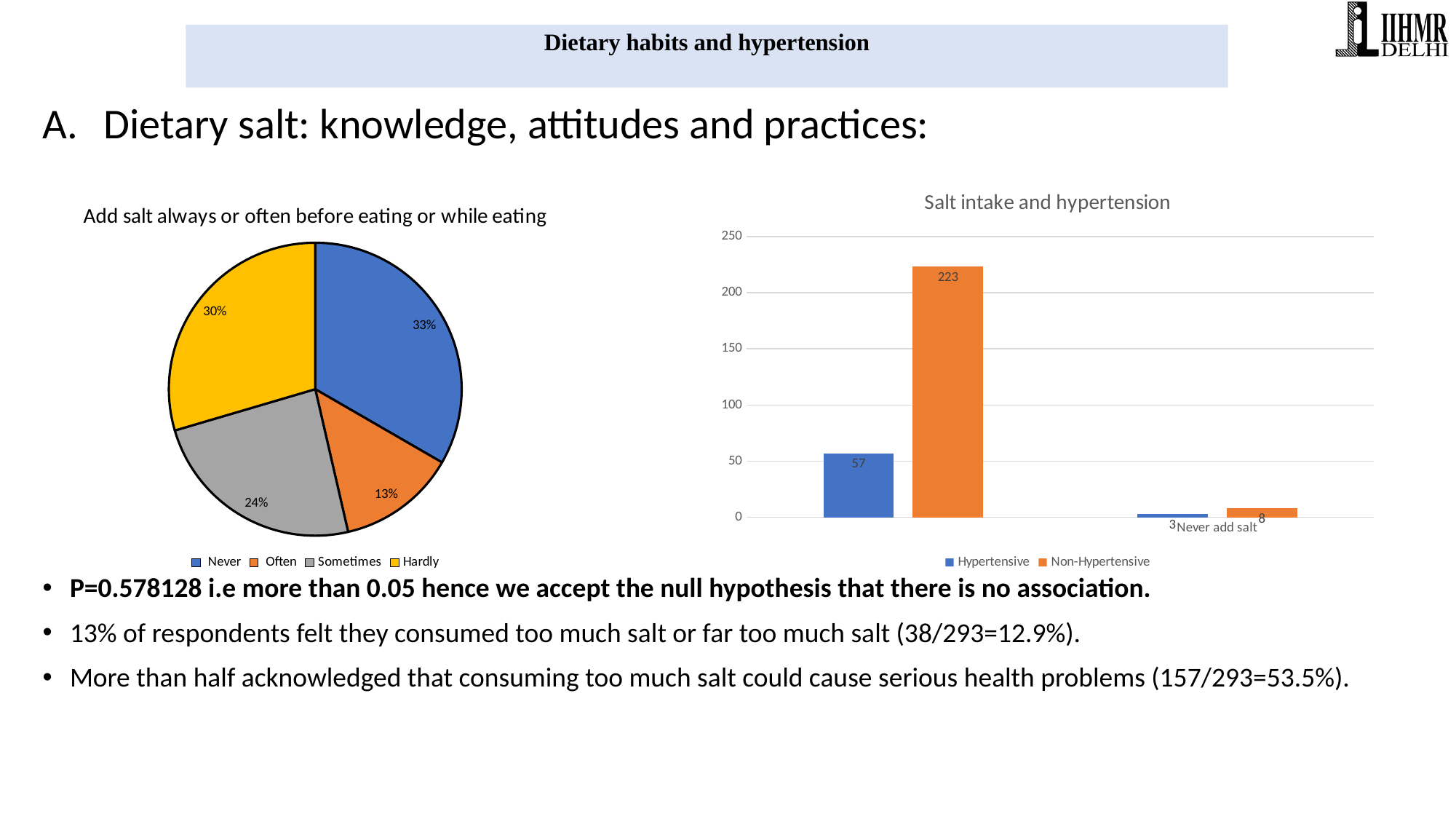
In the pie chart 'Add salt always or often before eating or while eating', what share does the 'Never' slice have? 33% In the chart 'Salt intake and hypertension', how many series does the legend list? 2 In the pie chart 'Add salt always or often before eating or while eating', what share does the 'Hardly' slice have? 30% In the pie chart 'Add salt always or often before eating or while eating', what is the difference between the 'Never' and 'Often' shares? 20% In the chart 'Salt intake and hypertension', what is the Non-Hypertensive value for 'Never add salt'? 8 In the chart 'Salt intake and hypertension', what is the Hypertensive value for 'Never add salt'? 3 In the pie chart 'Add salt always or often before eating or while eating', what share does the 'Sometimes' slice have? 24% In the pie chart 'Add salt always or often before eating or while eating', how many categories does the legend list? 4 In the chart 'Salt intake and hypertension', which series has the larger value for 'Never add salt'? Non-Hypertensive In the pie chart 'Add salt always or often before eating or while eating', which category has the largest slice? Never What kind of chart is 'Salt intake and hypertension'? Bar chart In the pie chart 'Add salt always or often before eating or while eating', which category has the smallest slice? Often